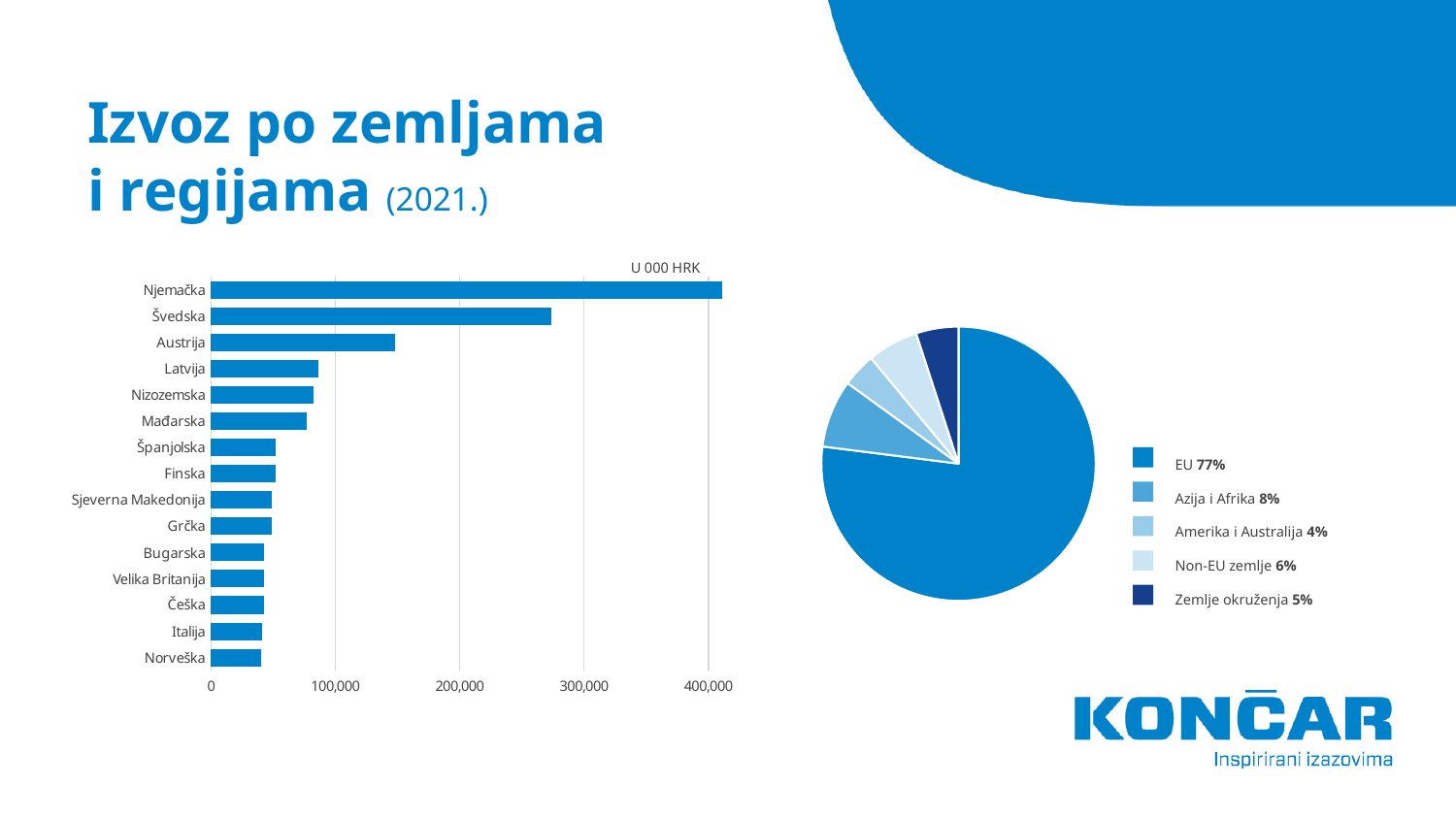
In the bar chart on the left, is the value for Njemačka greater or less than 400,000? greater In the bar chart on the left, is the value for Austrija greater or less than 100,000? greater In the bar chart on the left, is the value for Latvija greater or less than 100,000? less In the bar chart on the left, which country has the highest export value? Njemačka How many countries are shown in the bar chart on the left? 15 In the bar chart on the left, which has the larger export value, Švedska or Austrija? Švedska In the pie chart on the right, what is the difference between the EU share and the Non-EU zemlje share? 71% In the pie chart on the right, which region has the smallest share? Amerika i Australija What type of chart is the chart on the left of the slide? Bar chart In the pie chart on the right, what share of exports goes to Azija i Afrika? 8% In the bar chart on the left, which country has the lowest export value? Norveška